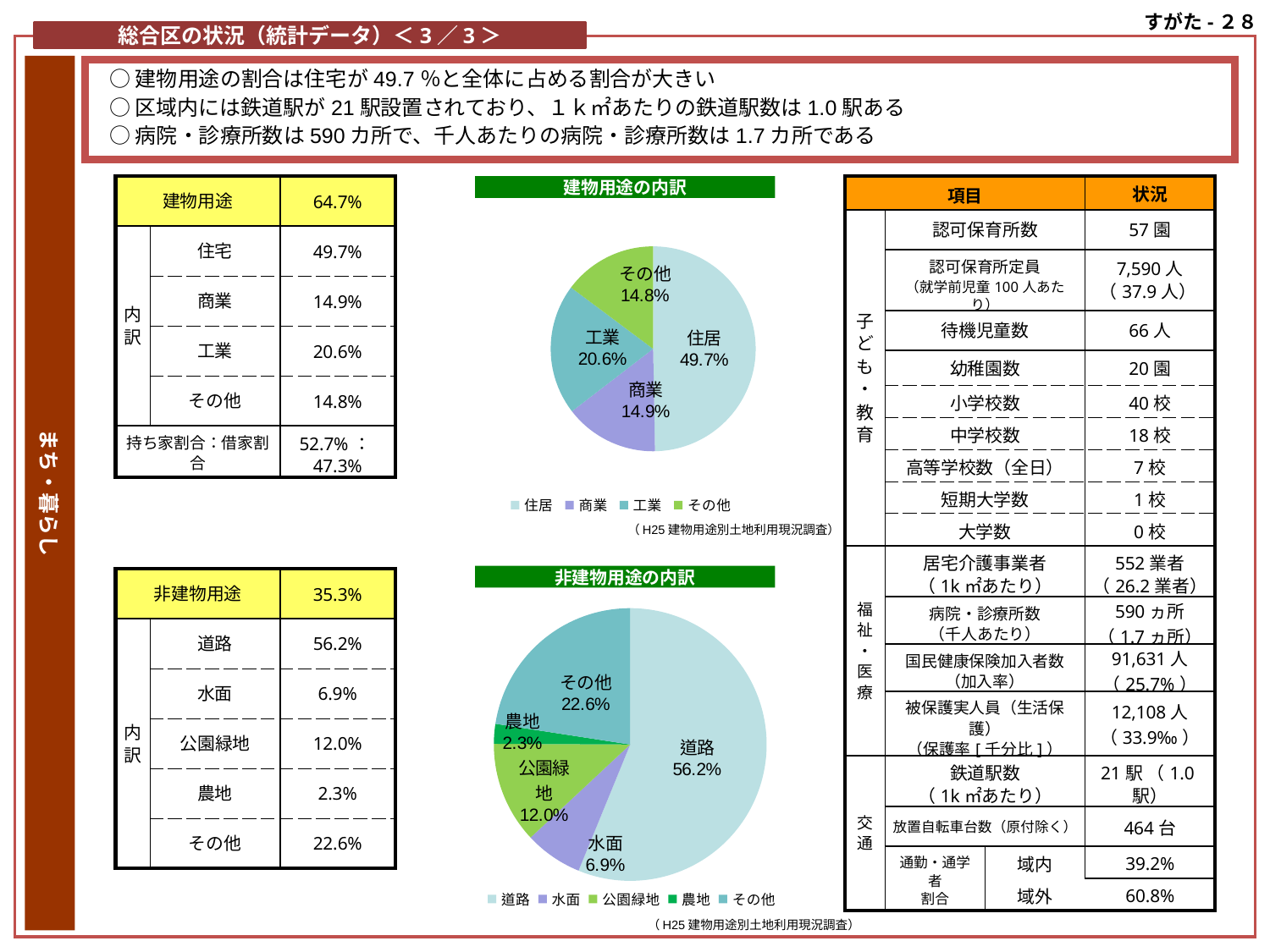
In the 建物用途の内訳 chart, which category has the largest share? 住居 In the 非建物用途の内訳 chart, which category has the smallest share? 農地 In the 建物用途の内訳 chart, what is the share for 住居? 49.7% In the 非建物用途の内訳 chart, which is larger, その他 or 水面? その他 In the 非建物用途の内訳 chart, how many categories does the legend list? 5 In the 非建物用途の内訳 chart, what is the difference between the shares of 道路 and その他? 33.6% In the 建物用途の内訳 chart, what is the share for 工業? 20.6% In the 建物用途の内訳 chart, what is the difference between the shares of 工業 and 商業? 5.7% In the 非建物用途の内訳 chart, what is the share for 道路? 56.2% What kind of chart is the 建物用途の内訳 chart? pie chart In the 建物用途の内訳 chart, how many categories does the legend list? 4 In the 非建物用途の内訳 chart, what is the share for 公園緑地? 12.0%